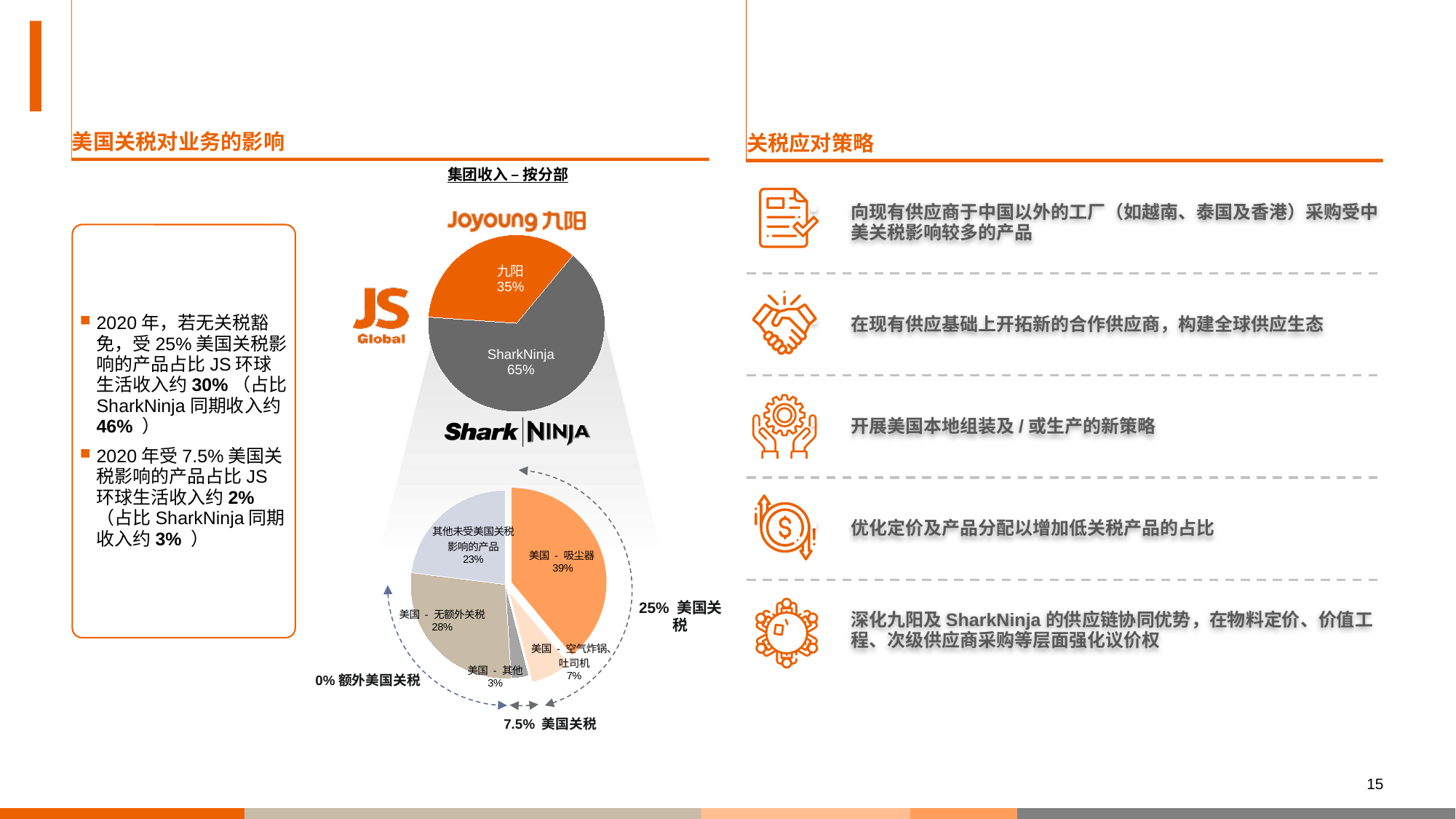
In the top pie chart titled 集团收入 – 按分部, what is the difference between the SharkNinja share and the 九阳 share? 30% In the lower SharkNinja pie chart, how many slices are there? 5 In the lower SharkNinja pie chart, what share is labelled 美国 - 空气炸锅、吐司机? 7% In the top pie chart titled 集团收入 – 按分部, what share of group revenue does SharkNinja account for? 65% In the lower SharkNinja pie chart, what share is labelled 其他未受美国关税影响的产品? 23% In the lower SharkNinja pie chart, what share is labelled 美国 - 无额外关税? 28% In the top pie chart titled 集团收入 – 按分部, what share of group revenue does 九阳 account for? 35% In the top pie chart titled 集团收入 – 按分部, how many segments are shown? 2 In the lower SharkNinja pie chart, what share is labelled 美国 - 吸尘器? 39% In the top pie chart titled 集团收入 – 按分部, which segment has the larger share? SharkNinja What type of chart is used to show 集团收入 – 按分部? Pie chart In the lower SharkNinja pie chart, which slice is the smallest? 美国 - 其他 (3%)